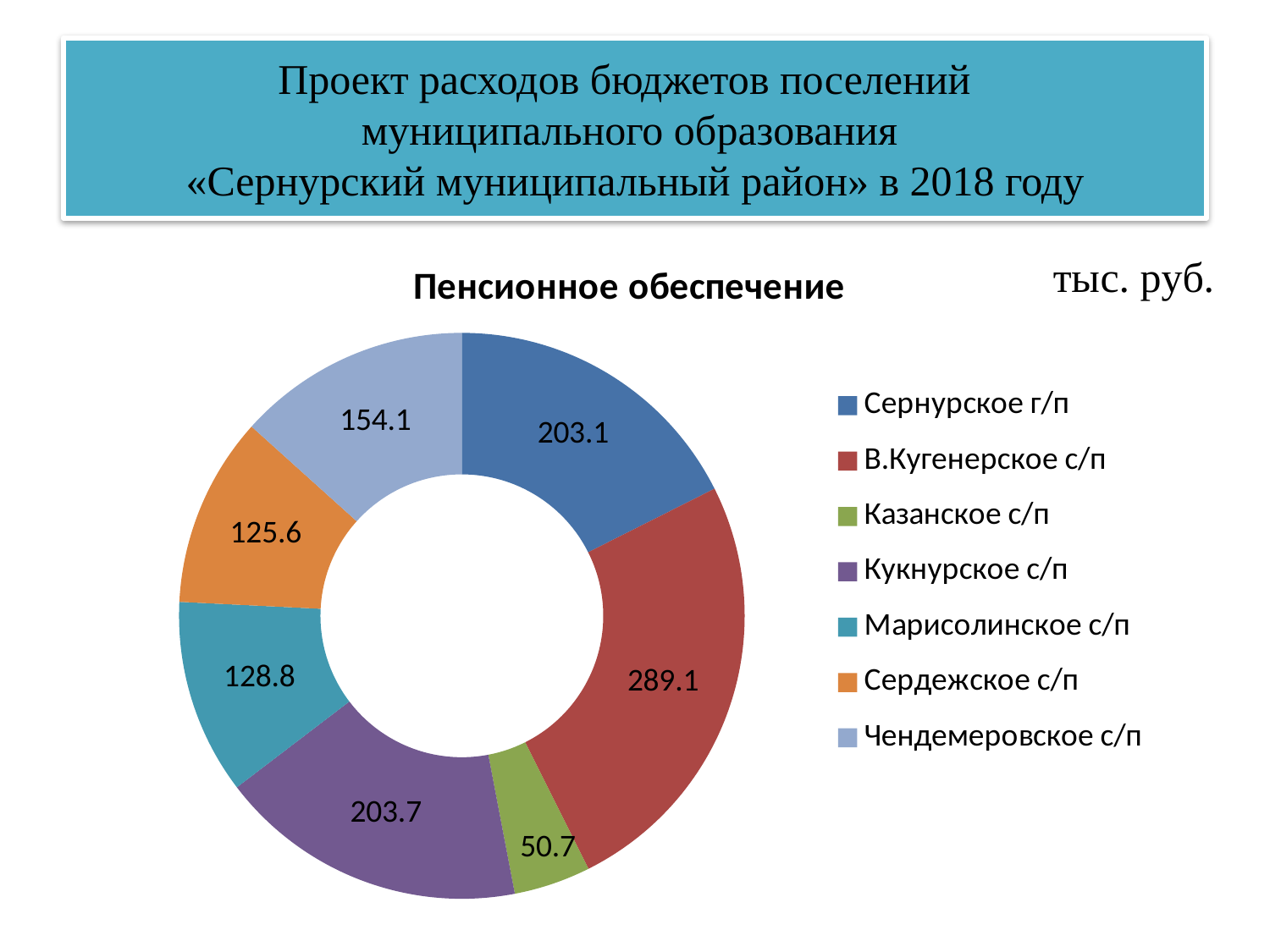
What is the value for В.Кугенерское с/п in the Пенсионное обеспечение chart? 289.1 Which settlement has the smallest value in the Пенсионное обеспечение chart? Казанское с/п Which settlement has the largest value in the Пенсионное обеспечение chart? В.Кугенерское с/п What is the difference between the values for В.Кугенерское с/п and Казанское с/п in the Пенсионное обеспечение chart? 238.4 What kind of chart is the Пенсионное обеспечение chart? doughnut chart What unit is indicated next to the Пенсионное обеспечение chart? тыс. руб. What is the value for Чендемеровское с/п in the Пенсионное обеспечение chart? 154.1 What is the value for Марисолинское с/п in the Пенсионное обеспечение chart? 128.8 How many settlements are shown in the Пенсионное обеспечение chart? 7 What is the difference between the values for Чендемеровское с/п and Сердежское с/п in the Пенсионное обеспечение chart? 28.5 What is the value for Казанское с/п in the Пенсионное обеспечение chart? 50.7 Which is larger in the Пенсионное обеспечение chart: the value for Сернурское г/п or the value for Чендемеровское с/п? Сернурское г/п